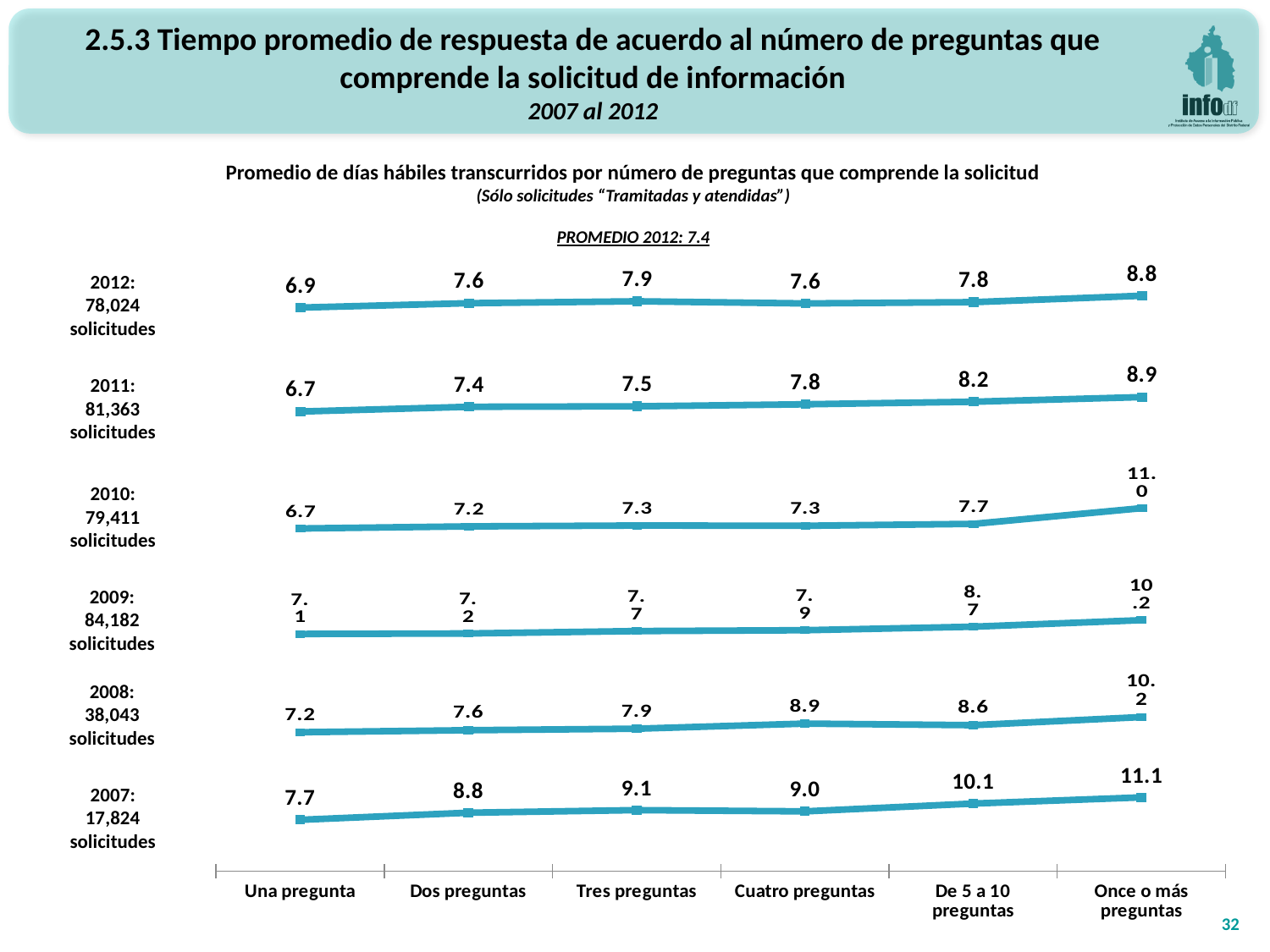
What kind of chart is used for each year on this slide? Line chart In the 2007 chart, what is the value for 'Once o más preguntas'? 11.1 In the 2010 chart, what is the value for 'De 5 a 10 preguntas'? 7.7 In the 2008 chart, which is larger: the value for 'Cuatro preguntas' or the value for 'De 5 a 10 preguntas'? Cuatro preguntas What is the 2012 overall average (PROMEDIO 2012) stated on the slide? 7.4 In the 2012 chart, what is the difference between the values for 'Once o más preguntas' and 'Una pregunta'? 1.9 In the 2011 chart, do the values rise or fall from 'Una pregunta' to 'Once o más preguntas'? Rise In the 2008 chart, which category has the lowest value? Una pregunta How many categories are shown along the x axis of each chart? 6 How many solicitudes are reported for the 2009 chart? 84,182 In the 2012 chart, what is the average number of business days for requests with 'Una pregunta'? 6.9 In the 2011 chart, which category has the highest value? Once o más preguntas